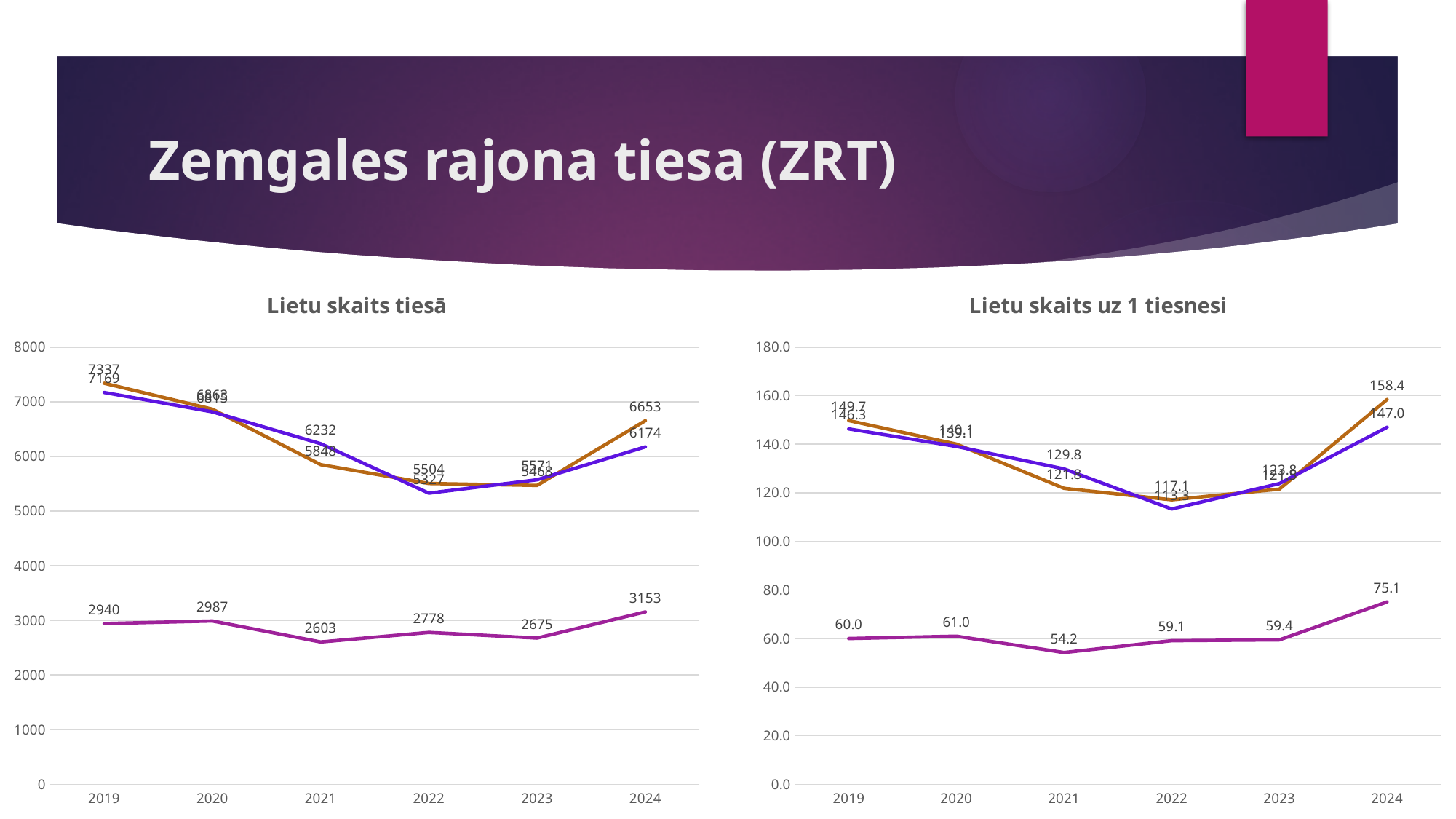
In the left chart "Lietu skaits tiesā", is the purple line's value for 2021 greater or less than 6000? greater In the right chart "Lietu skaits uz 1 tiesnesi", what is the value of the magenta line for 2021? 54.2 In the left chart "Lietu skaits tiesā", what is the difference between the magenta line's values for 2024 and 2019? 213 In the left chart "Lietu skaits tiesā", what is the value of the orange line for 2019? 7337 In the left chart "Lietu skaits tiesā", how many years are shown on the x axis? 6 In the right chart "Lietu skaits uz 1 tiesnesi", what is the difference between the magenta line's values for 2024 and 2023? 15.7 In the left chart "Lietu skaits tiesā", in which year is the magenta line lowest? 2021 What kind of chart is the left chart titled "Lietu skaits tiesā"? line chart In the left chart "Lietu skaits tiesā", which is larger for 2024: the orange line or the purple line? the orange line In the right chart "Lietu skaits uz 1 tiesnesi", in which year is the magenta line highest? 2024 In the left chart "Lietu skaits tiesā", what is the value of the magenta line for 2024? 3153 In the right chart "Lietu skaits uz 1 tiesnesi", what is the value of the orange line for 2024? 158.4